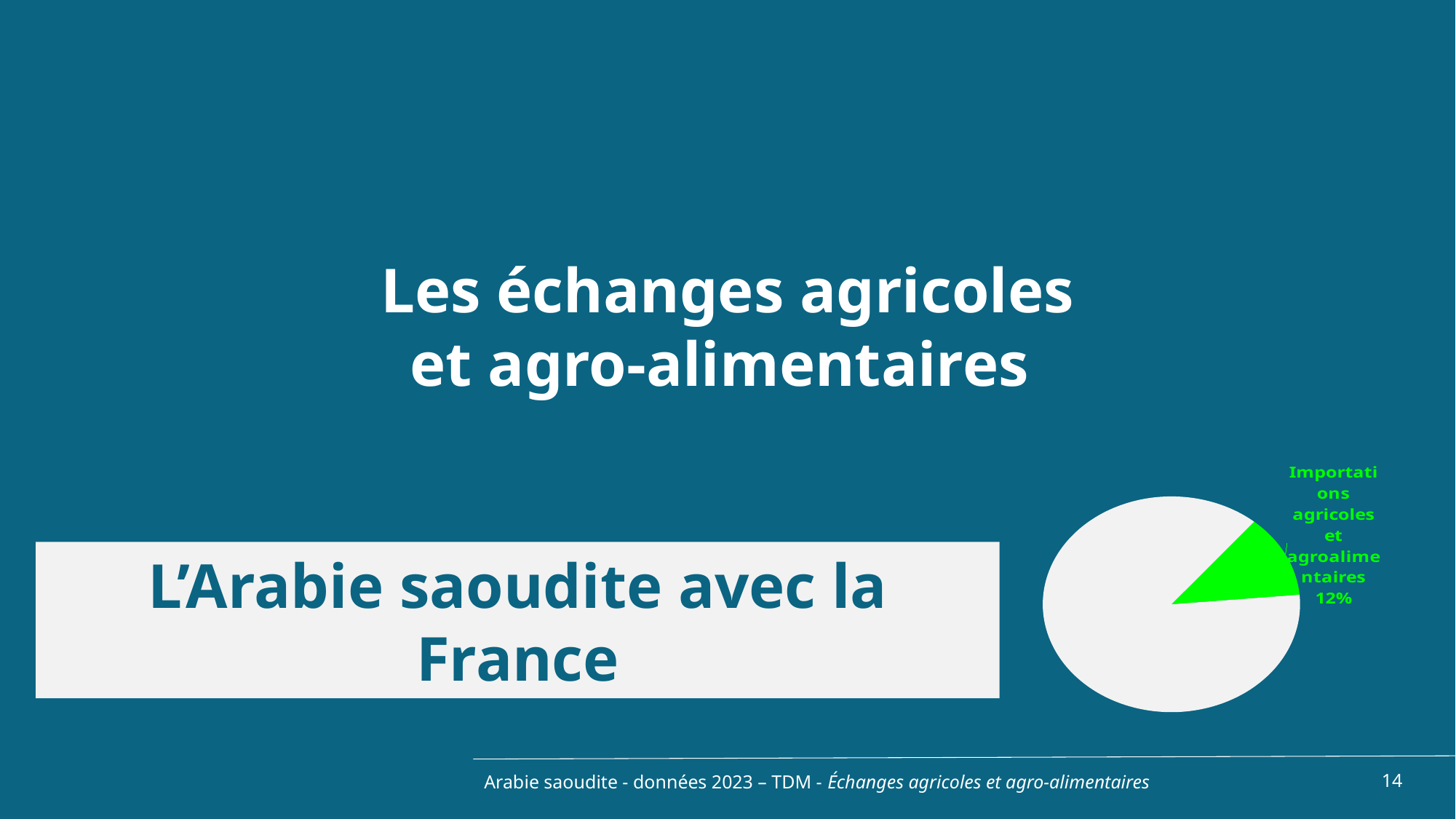
Which slice of the pie chart is the smallest? Importations agricoles et agroalimentaires What share of the pie does the slice labelled "Importations agricoles et agroalimentaires" represent? 12% What kind of chart is shown on the right of the slide? pie chart How many slices does the pie chart have? 2 What colour is the slice labelled "Importations agricoles et agroalimentaires" in the pie chart? green What is the value printed for the green slice of the pie chart? 12% Is the share of the green slice in the pie chart greater or less than 50%? less Is the green slice of the pie chart larger or smaller than the white slice? smaller